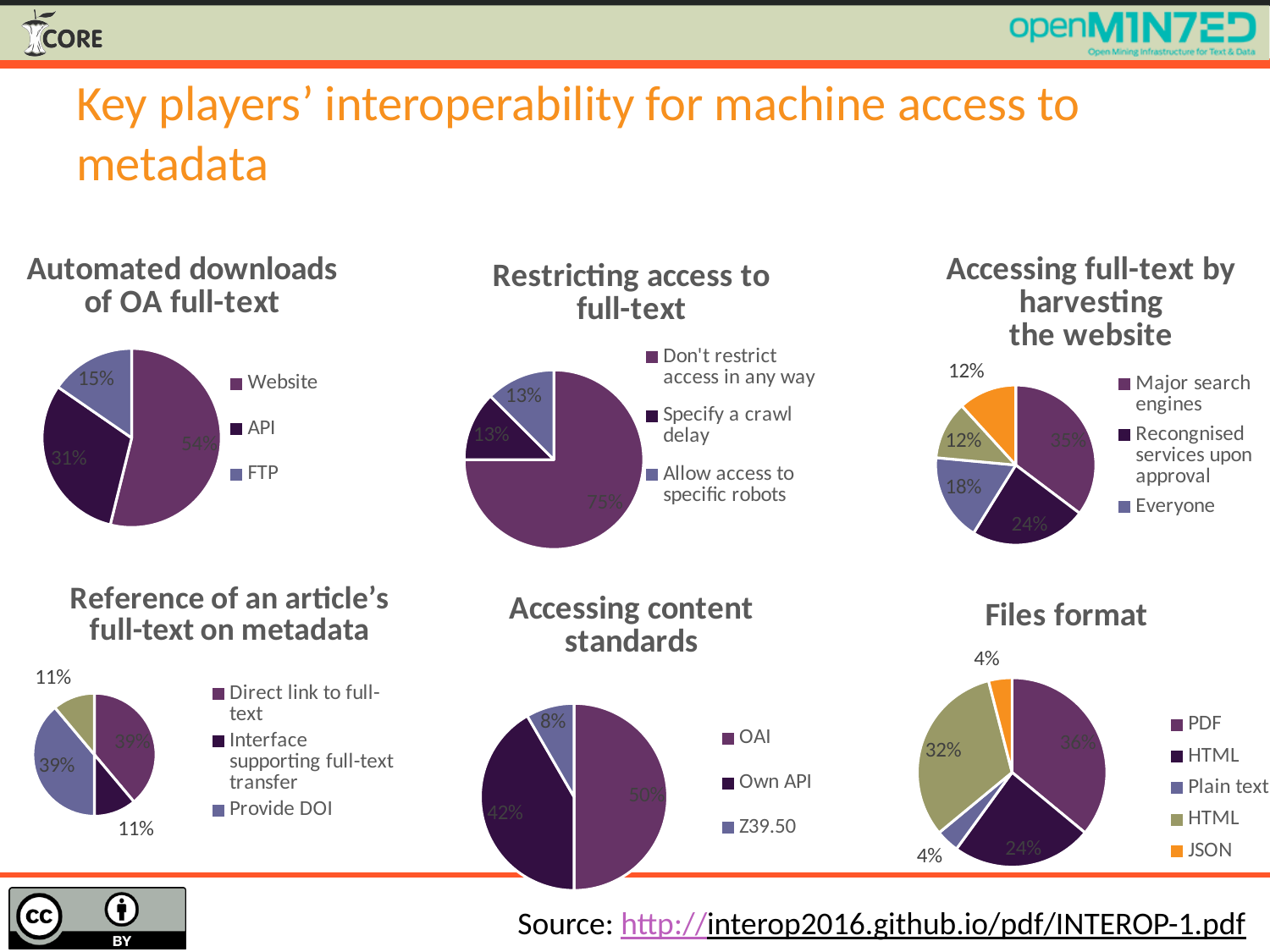
In the 'Accessing content standards' chart, which category has the smallest share? Z39.50 In the 'Accessing full-text by harvesting the website' chart, what share is Everyone? 18% In the 'Accessing full-text by harvesting the website' chart, what share is 'Major search engines'? 35% In the 'Accessing content standards' chart, what share is OAI? 50% In the 'Automated downloads of OA full-text' chart, what share is Website? 54% In the 'Automated downloads of OA full-text' chart, which category has the largest share? Website In the 'Restricting access to full-text' chart, what share is 'Don't restrict access in any way'? 75% In the 'Files format' chart, what share is PDF? 36% What kind of chart is the 'Files format' chart? Pie chart How many legend entries does the 'Restricting access to full-text' chart list? 3 In the 'Automated downloads of OA full-text' chart, what is the difference between the Website and API shares? 23 percentage points In the 'Accessing content standards' chart, which is larger: Own API or Z39.50? Own API